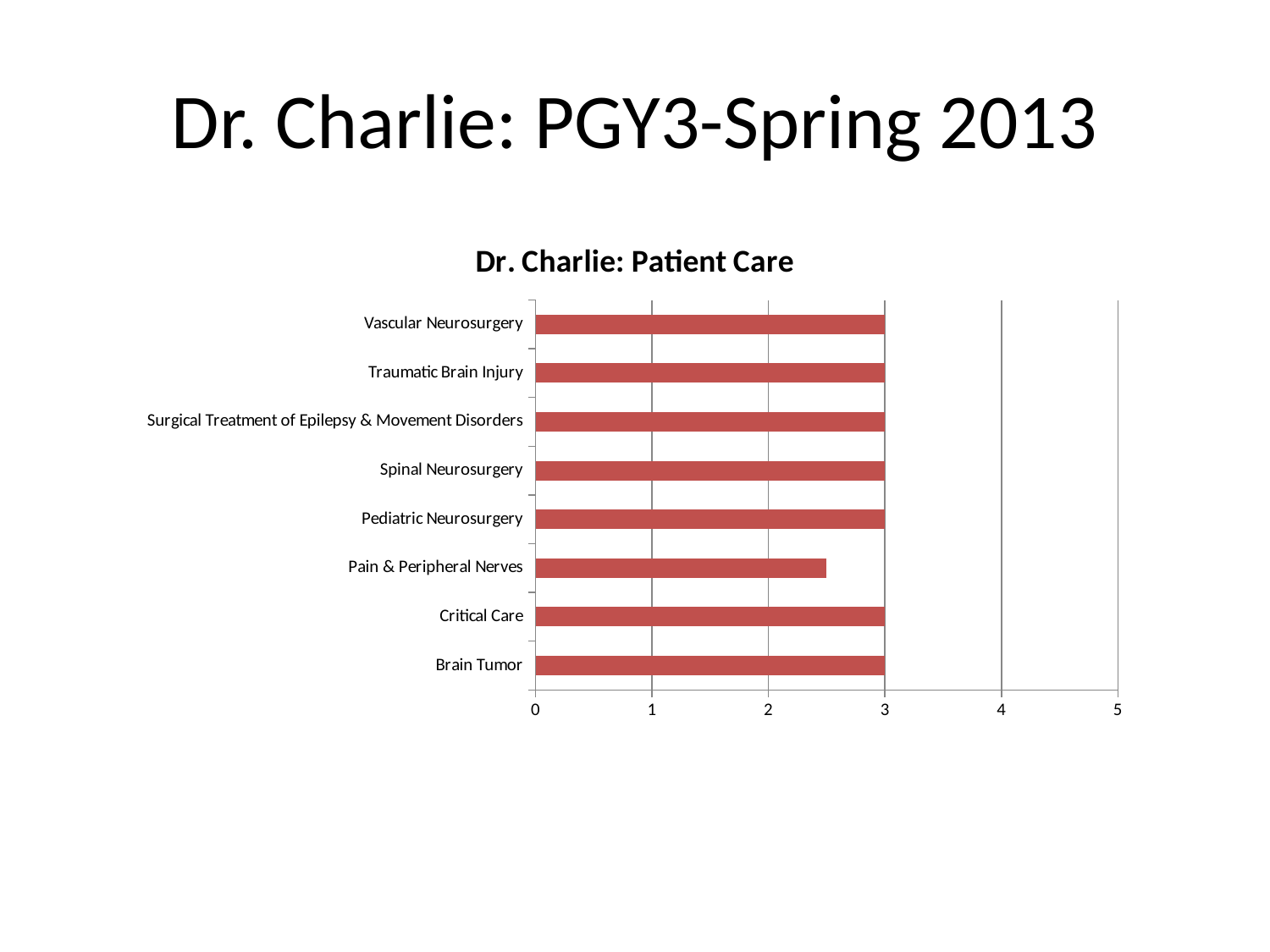
What is the value for Critical Care? 3 What is the value for Pediatric Neurosurgery? 3 Which category has the lowest value in the chart? Pain & Peripheral Nerves Is the value for Pain & Peripheral Nerves greater or less than 3? less What is the maximum value shown on the horizontal axis? 5 What type of chart is shown on the slide? bar chart Is the value for Pain & Peripheral Nerves greater or less than 2? greater How many categories are plotted in the chart? 8 What is the value for Brain Tumor? 3 What is the value for Vascular Neurosurgery? 3 Which is larger, the value for Spinal Neurosurgery or the value for Pain & Peripheral Nerves? Spinal Neurosurgery What is the title of the chart? Dr. Charlie: Patient Care